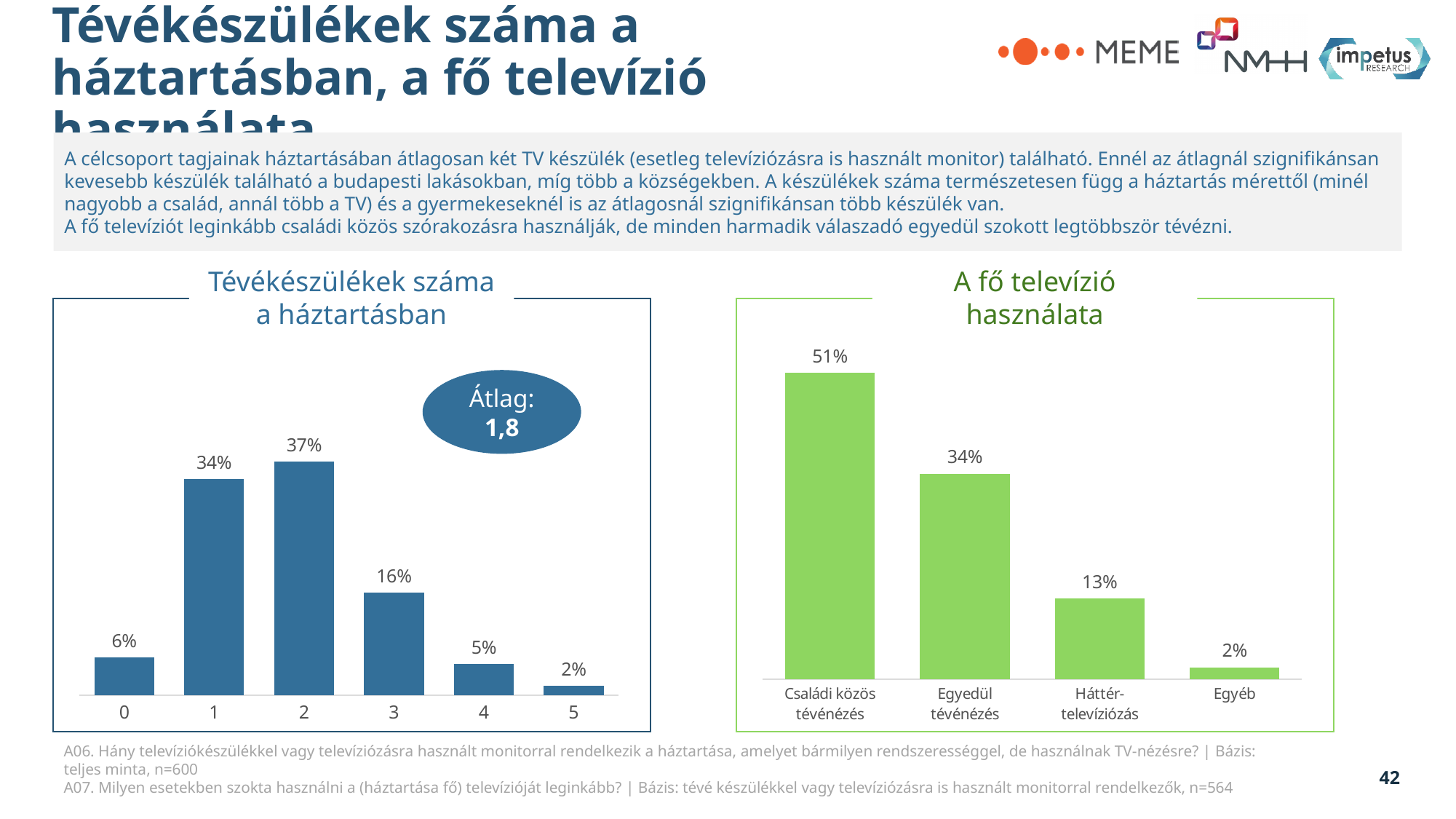
In the chart 'A fő televízió használata', what is the value for 'Háttér-televíziózás'? 13% In the chart 'Tévékészülékek száma a háztartásban', what is the difference between the shares for 1 and 3 TV sets? 18 percentage points In the chart 'Tévékészülékek száma a háztartásban', how many categories are shown on the x axis? 6 In the chart 'Tévékészülékek száma a háztartásban', which number of TV sets has the lowest share? 5 In the chart 'Tévékészülékek száma a háztartásban', what average (Átlag) value is shown? 1,8 In the chart 'A fő televízió használata', which category has the lowest value? Egyéb What type of chart is 'A fő televízió használata'? Bar chart In the chart 'A fő televízió használata', what is the difference between 'Családi közös tévénézés' and 'Egyedül tévénézés'? 17 percentage points In the chart 'Tévékészülékek száma a háztartásban', what percentage of households have 2 TV sets? 37% In the chart 'A fő televízió használata', what is the value for 'Családi közös tévénézés'? 51% In the chart 'Tévékészülékek száma a háztartásban', which number of TV sets has the highest share? 2 In the chart 'Tévékészülékek száma a háztartásban', what percentage of households have 0 TV sets? 6%